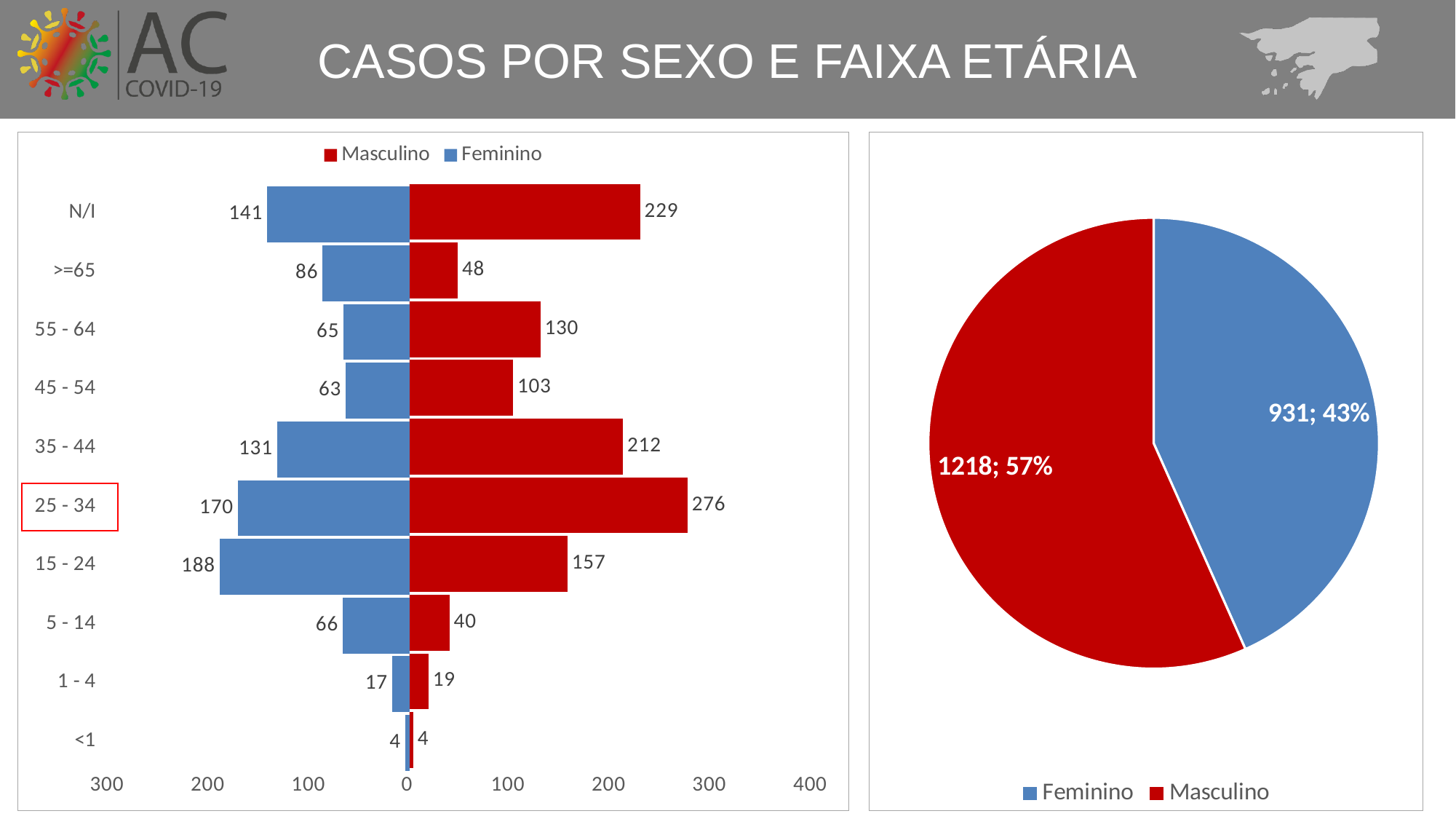
In the left bar chart, how many age groups are shown? 10 What kind of chart is on the left side of the slide? Bar chart In the left bar chart, what is the Masculino value for the 25 - 34 age group? 276 In the left bar chart, which is larger for the >=65 group, Masculino or Feminino? Feminino In the left bar chart, which age group has the highest Masculino value? 25 - 34 In the pie chart on the right, what value and share are shown for the Masculino slice? 1218; 57% In the left bar chart, which colour represents Masculino? Red In the pie chart on the right, what is the value shown for the Feminino slice? 931 In the left bar chart, how many series does the legend list? 2 In the left bar chart, what is the Feminino value for the 15 - 24 age group? 188 In the left bar chart, which age group has the lowest Feminino value? <1 In the left bar chart, what is the difference between the Masculino and Feminino values for the N/I group? 88